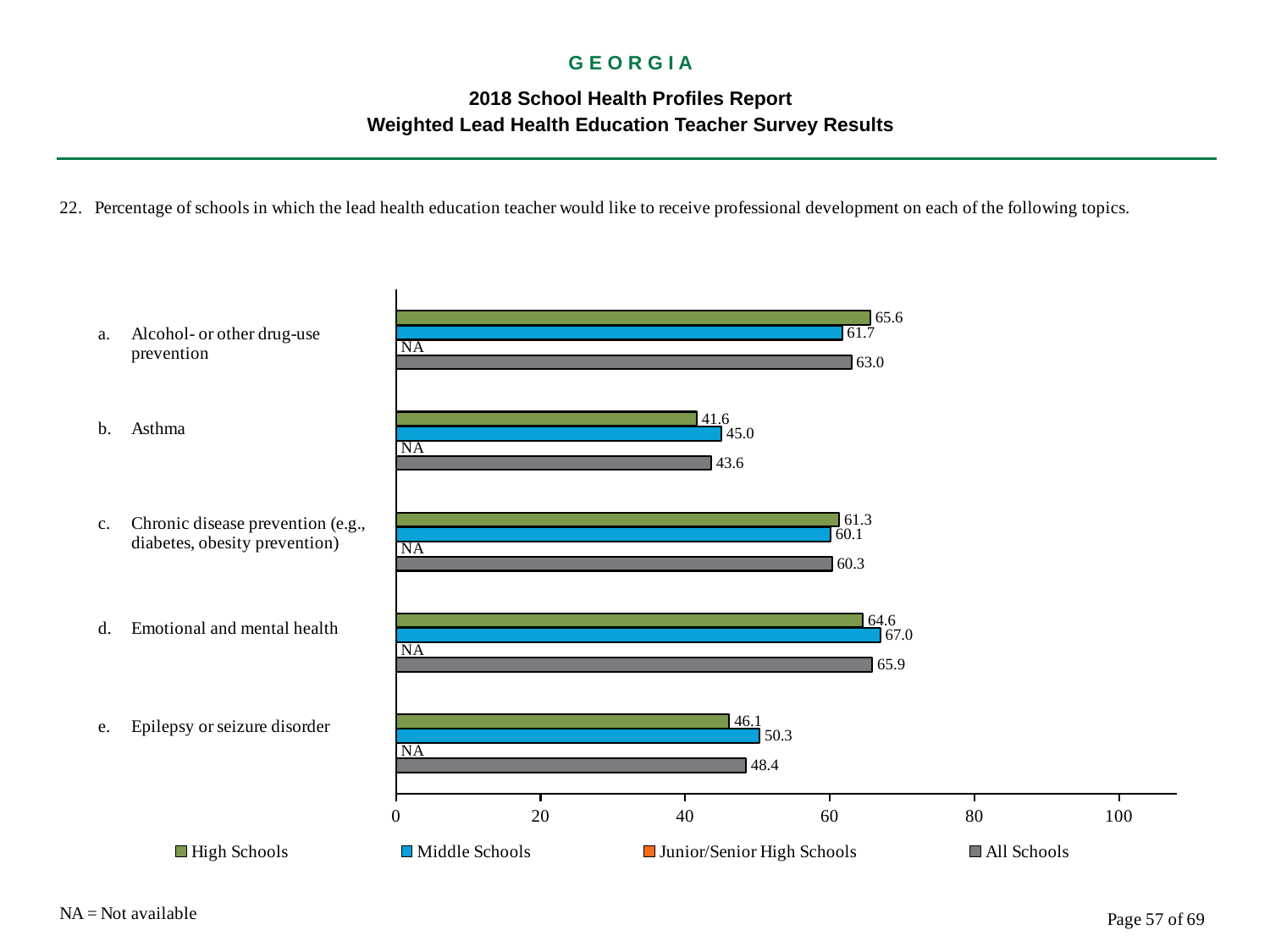
Which is larger for Epilepsy or seizure disorder: the High Schools value or the Middle Schools value? Middle Schools What is the value for All Schools for Asthma? 43.6 Which topic has the highest value for All Schools? Emotional and mental health What is the value for Middle Schools for Epilepsy or seizure disorder? 50.3 Which topic has the lowest value for High Schools? Asthma How many topics are listed on the chart? 5 What is the difference between the Middle Schools and High Schools values for Asthma? 3.4 What is the value for Middle Schools for Emotional and mental health? 67.0 What is the value for High Schools for Alcohol- or other drug-use prevention? 65.6 What kind of chart is shown on the slide? bar chart How many series does the legend list? 4 Is the All Schools value for Chronic disease prevention greater or less than 40? greater